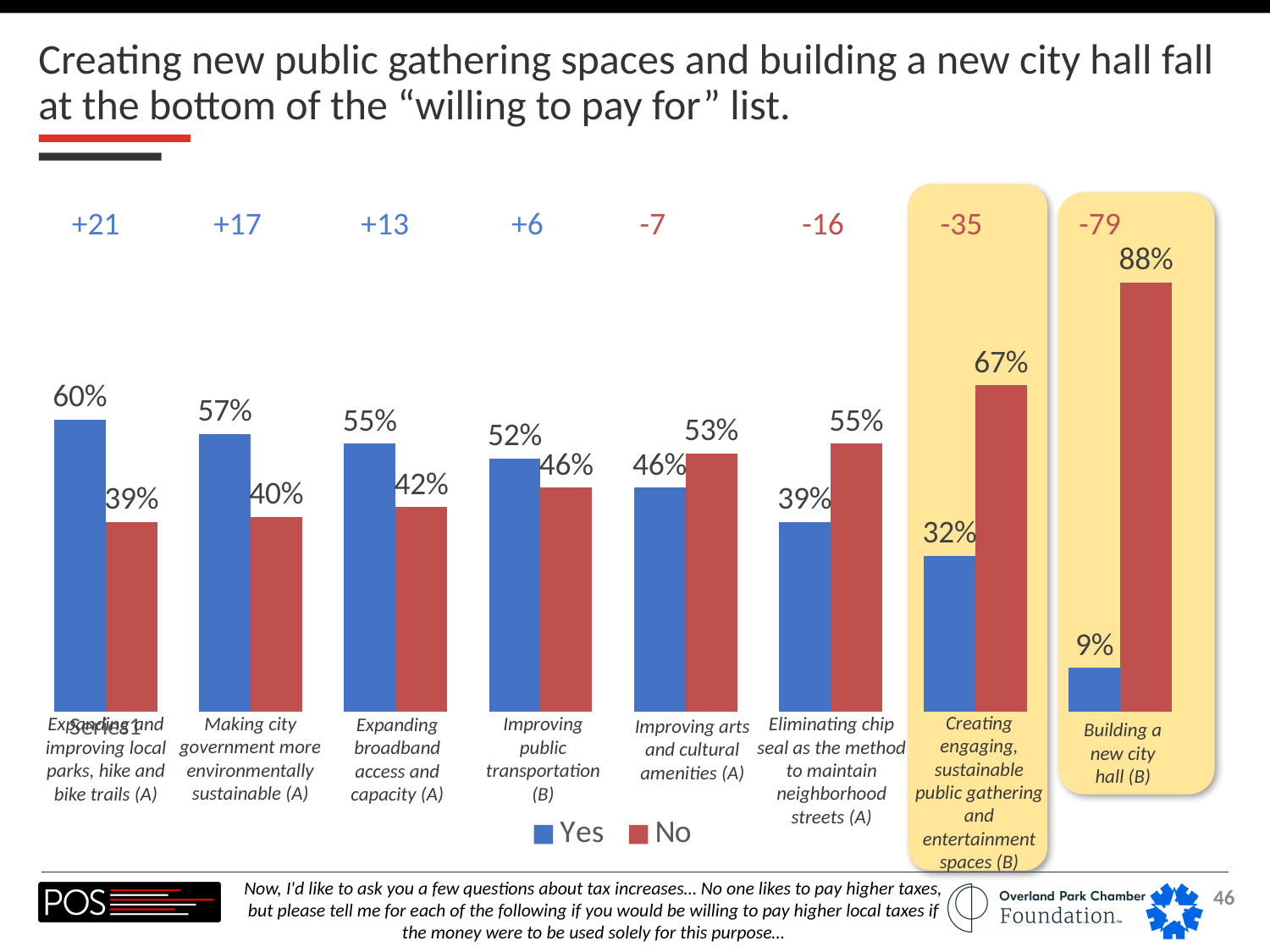
What is the difference between the Yes and No values for improving public transportation? 6 percentage points What kind of chart is shown on the slide? Bar chart Which category has the highest No value? Building a new city hall (B) What net figure is printed above the bars for eliminating chip seal as the method to maintain neighborhood streets? -16 What percentage of respondents said Yes to paying higher taxes for expanding and improving local parks, hike and bike trails? 60% Do the Yes values rise or fall moving from left to right across the categories? Fall Which category has the lowest Yes value? Building a new city hall (B) What is the No value for building a new city hall? 88% How many series does the legend list? 2 What is the Yes value for creating engaging, sustainable public gathering and entertainment spaces? 32% How many categories are shown on the chart? 8 For improving arts and cultural amenities, which is larger, the Yes value or the No value? No